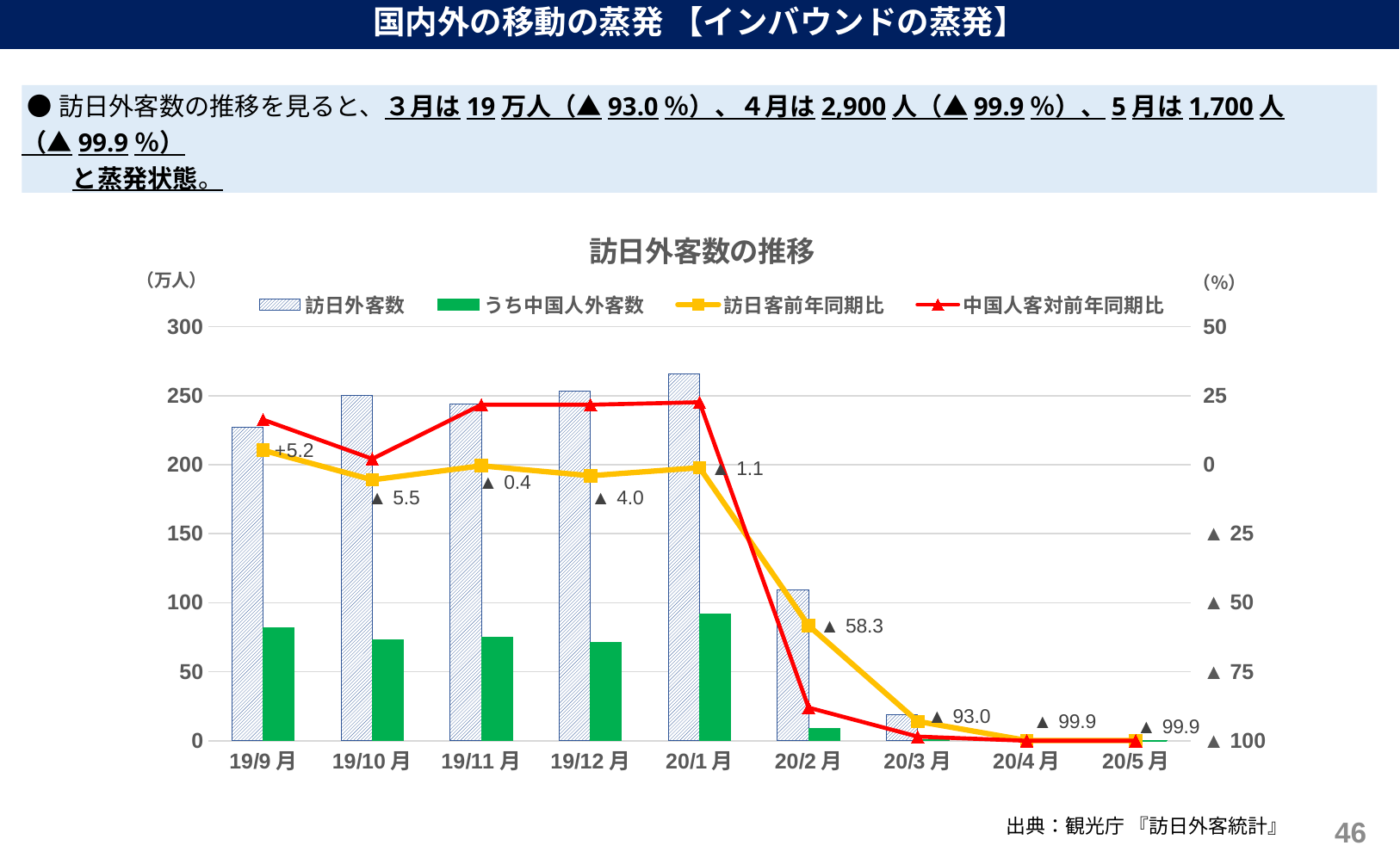
In which month is the 訪日外客数 bar the highest? 20/1月 What is the 訪日客前年同期比 value labelled for 20/1月? ▲ 1.1 How many months are shown on the x axis of the chart? 9 What kind of chart is shown on the slide? Combination bar and line chart What is the 訪日客前年同期比 value labelled for 19/9月? +5.2 How many series does the chart legend list? 4 Which is larger, the 訪日外客数 bar for 19/9月 or for 19/10月? 19/10月 Is the 訪日外客数 value for 20/1月 greater or less than 250? greater What is the title of the chart? 訪日外客数の推移 What is the 訪日客前年同期比 value labelled for 20/3月? ▲ 93.0 Does the 訪日外客数 bar rise or fall from 20/1月 to 20/5月? fall What is the 訪日客前年同期比 value labelled for 20/2月? ▲ 58.3